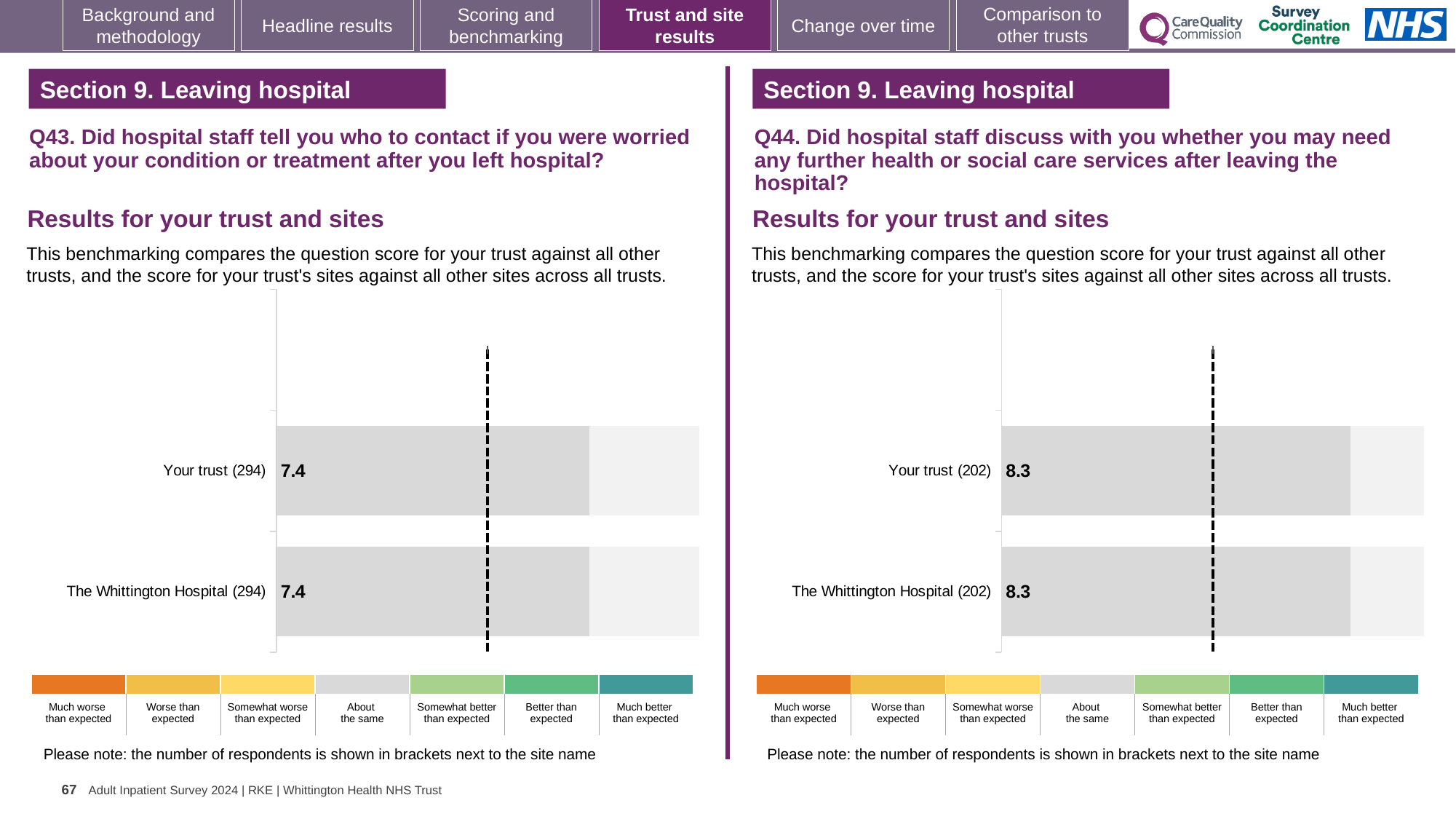
On the left chart (Q43), what is the score for Your trust? 7.4 On the right chart (Q44), what is the score for The Whittington Hospital? 8.3 How many categories does the colour legend below the left chart (Q43) list? 7 On the right chart (Q44), how many respondents are shown in brackets for The Whittington Hospital? 202 On the left chart (Q43), how many bars are plotted? 2 On the left chart (Q43), what is the score for The Whittington Hospital? 7.4 On the left chart (Q43), how many respondents are shown in brackets for Your trust? 294 On the right chart (Q44), how many bars are plotted? 2 On the right chart (Q44), what is the score for Your trust? 8.3 On the right chart (Q44), which benchmarking category does the grey colour of the bars correspond to in the legend? About the same What kind of chart is used on the left (Q43) to show the results for your trust and sites? Bar chart On the left chart (Q43), what is the difference between the score for Your trust and the score for The Whittington Hospital? 0